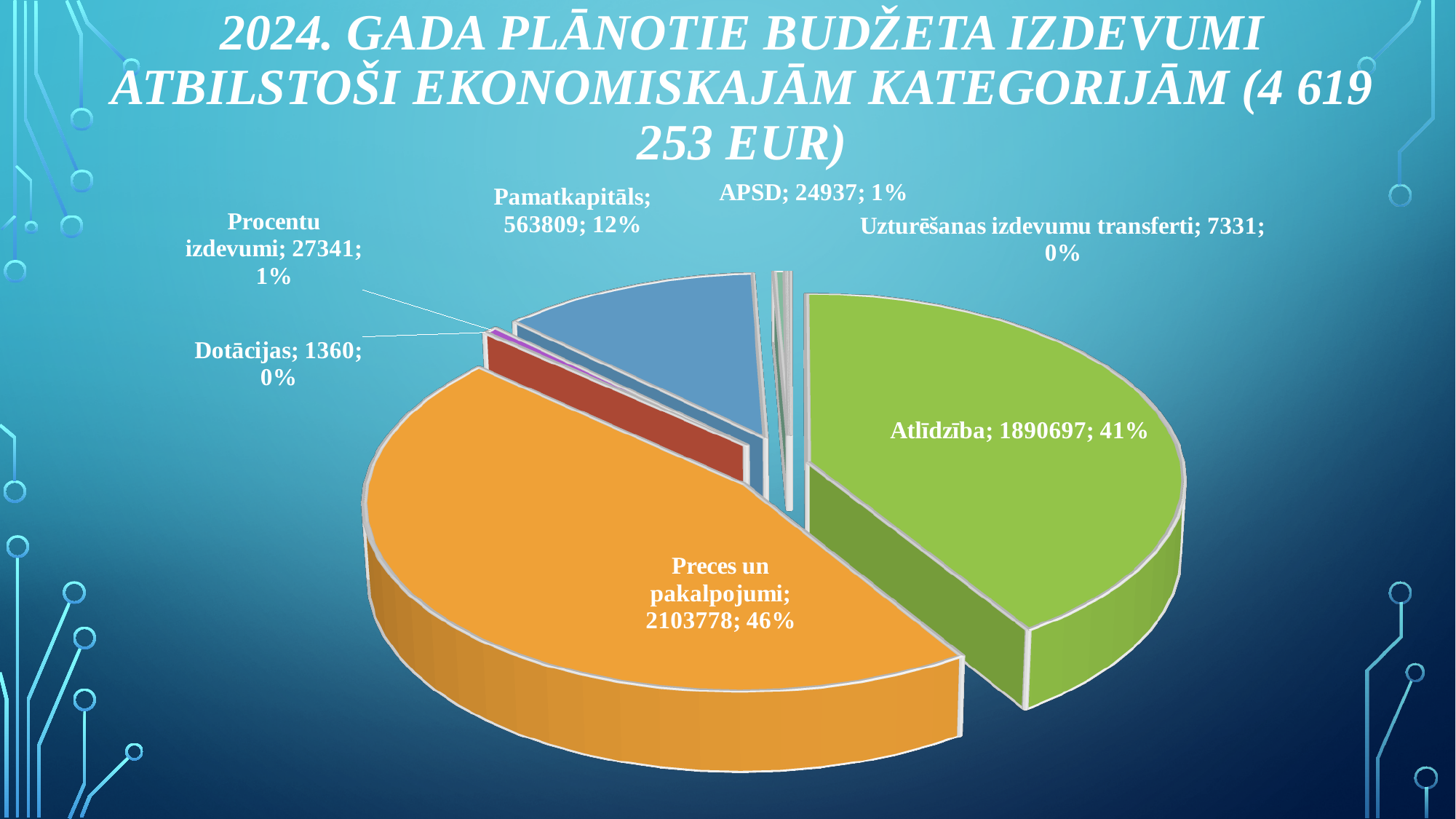
What is the value for APSD? 24937 Which category has the smallest value? Dotācijas What is the value for Preces un pakalpojumi? 2103778 Which is larger, the value for Procentu izdevumi or the value for APSD? Procentu izdevumi Which category has the largest value? Preces un pakalpojumi How many categories does the pie chart show? 7 What kind of chart is shown on the slide? pie chart What share of the pie does Atlīdzība represent? 41% What is the value for Pamatkapitāls? 563809 What is the value for Atlīdzība? 1890697 What share of the pie does Pamatkapitāls represent? 12% What is the difference between the values for Preces un pakalpojumi and Atlīdzība? 213081